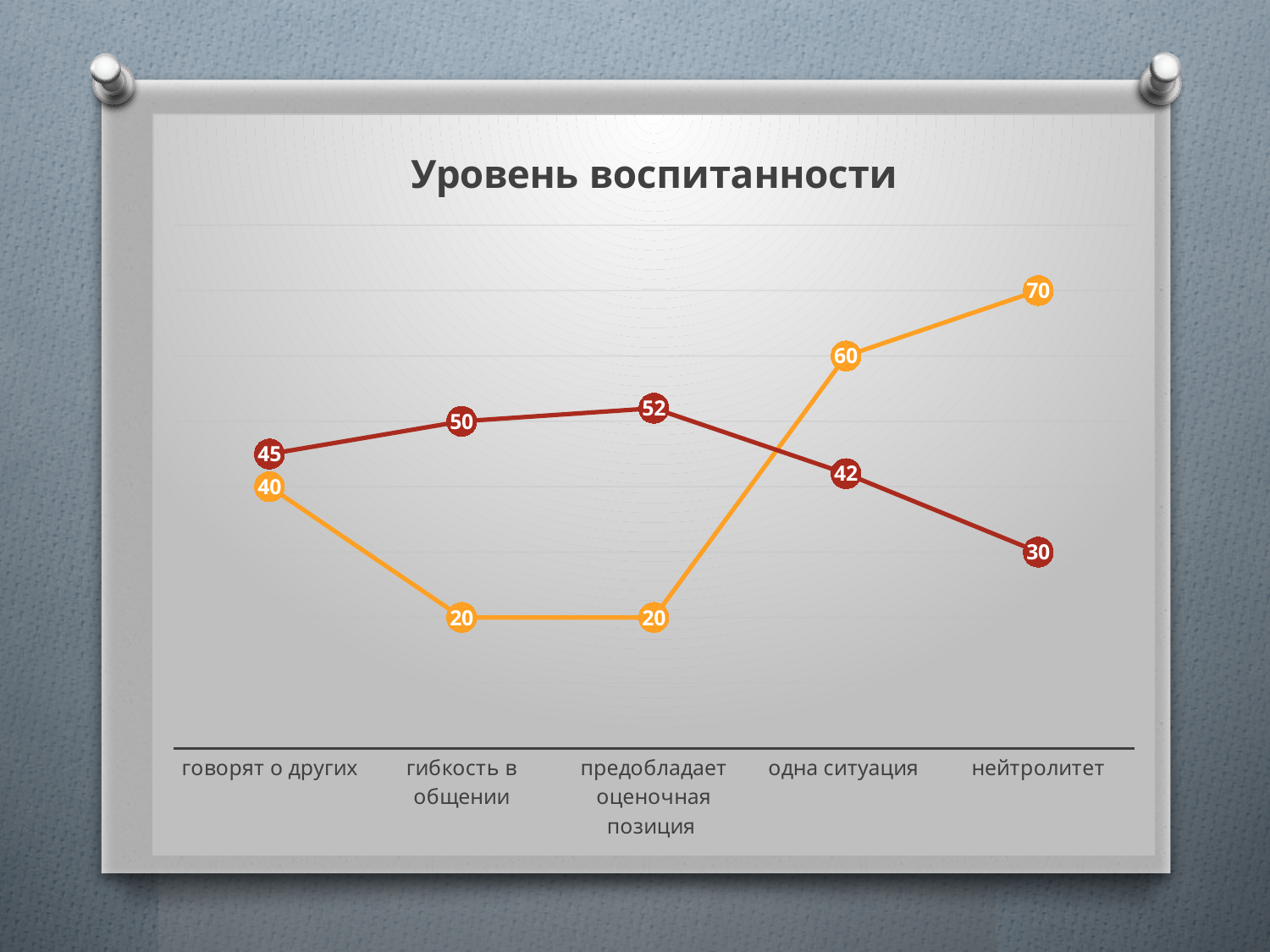
What is the value of the orange line for 'нейтролитет'? 70 What is the value of the orange line for 'гибкость в общении'? 20 For which category does the dark red line have its lowest value? нейтролитет What is the difference between the orange and dark red values for 'нейтролитет'? 40 What kind of chart is shown on the slide? line chart What is the value of the dark red line for 'говорят о других'? 45 What is the title of the chart? Уровень воспитанности Which line has the larger value for 'одна ситуация', the orange line or the dark red line? orange line What is the value of the dark red line for 'одна ситуация'? 42 For which category does the dark red line reach its highest value? предобладает оценочная позиция How many lines are plotted on the chart? 2 How many categories are shown on the x axis? 5